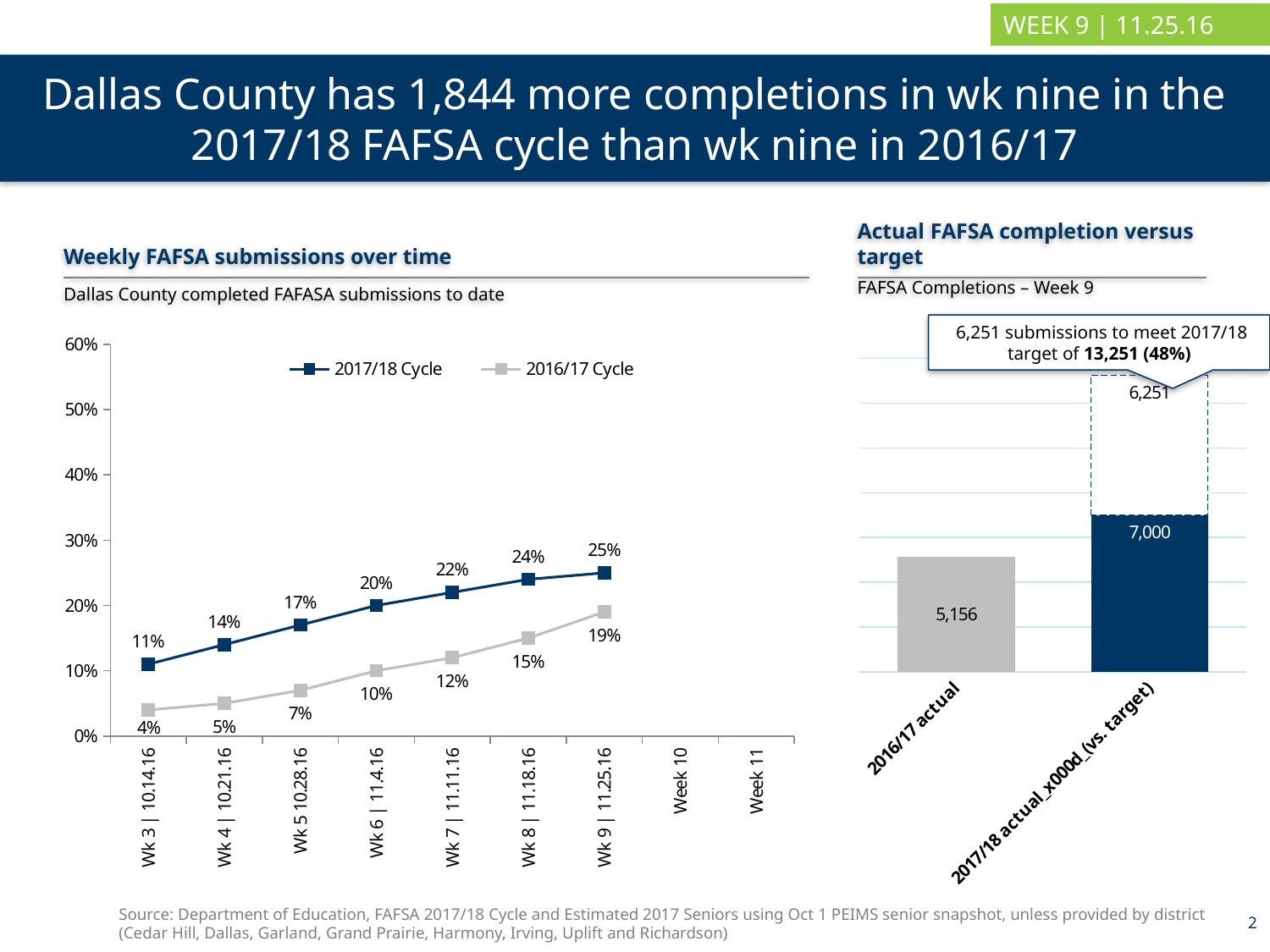
In the 'Weekly FAFSA submissions over time' chart, which is larger at Wk 5 10.28.16: the 2017/18 Cycle or the 2016/17 Cycle? 2017/18 Cycle In the 'Weekly FAFSA submissions over time' chart, what is the difference between the 2017/18 Cycle and the 2016/17 Cycle at Wk 9 | 11.25.16? 6% In the 'Weekly FAFSA submissions over time' chart, how many series does the legend list? 2 What kind of chart is the 'Weekly FAFSA submissions over time' chart? line chart In the 'Weekly FAFSA submissions over time' chart, what is the value for the 2017/18 Cycle at Wk 9 | 11.25.16? 25% In the 'Weekly FAFSA submissions over time' chart, what is the value for the 2016/17 Cycle at Wk 7 | 11.11.16? 12% In the 'Actual FAFSA completion versus target' chart, what is the total of the stacked 2017/18 bar (actual plus remaining to target)? 13,251 In the 'Weekly FAFSA submissions over time' chart, do the 2017/18 Cycle values rise or fall from Wk 3 to Wk 9? rise In the 'Actual FAFSA completion versus target' chart, what is the value for 2016/17 actual? 5,156 In the 'Weekly FAFSA submissions over time' chart, at which week is the 2016/17 Cycle value lowest? Wk 3 | 10.14.16 In the 'Weekly FAFSA submissions over time' chart, what is the value for the 2016/17 Cycle at Wk 3 | 10.14.16? 4% What kind of chart is the 'Actual FAFSA completion versus target' chart? bar chart